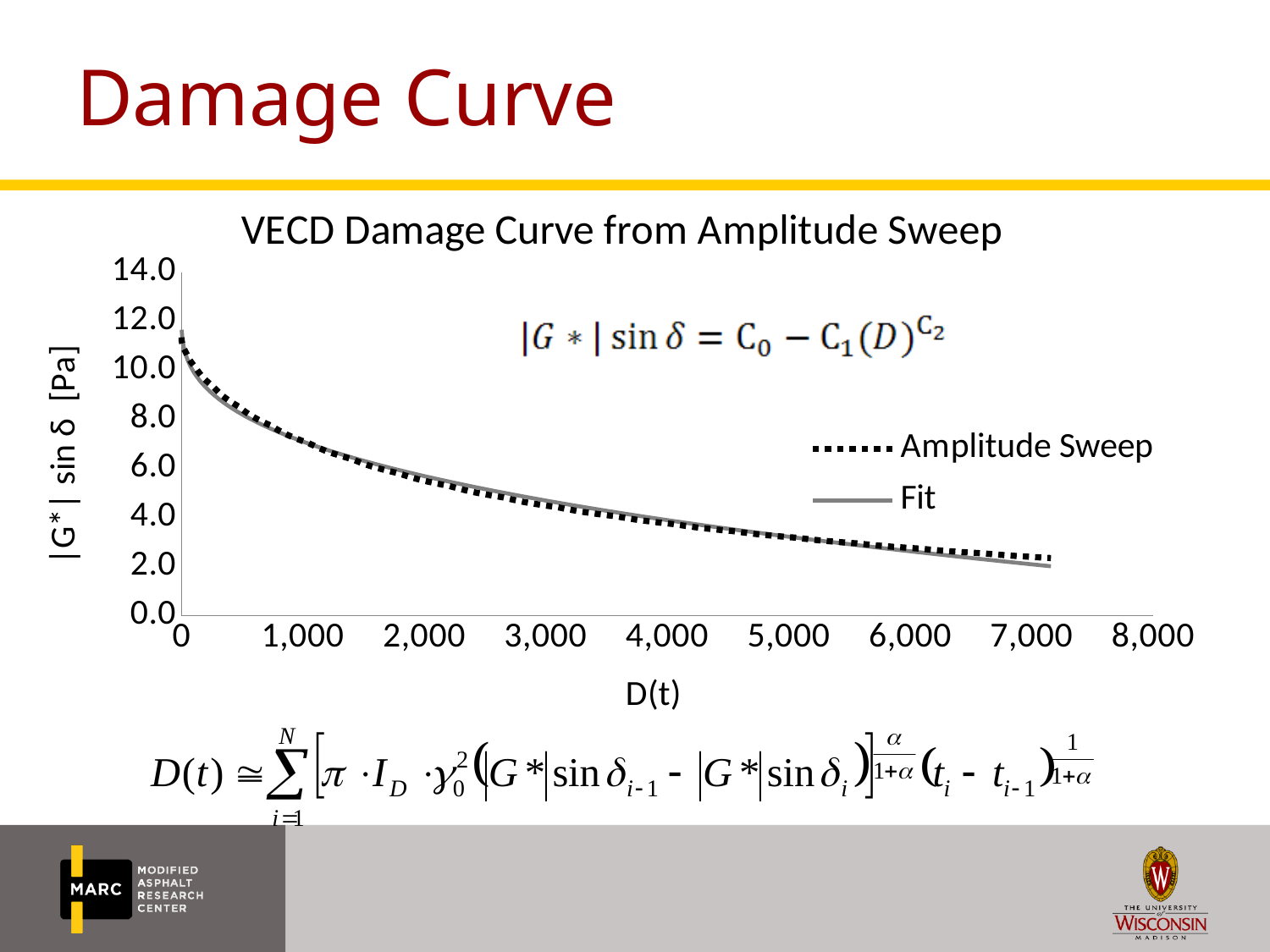
Is the value of the Amplitude Sweep series at D(t) = 1,000 greater or less than 8.0? less Is the value of the Amplitude Sweep series at D(t) = 2,000 greater or less than 4.0? greater How many series does the legend list? 2 What are the two series named in the legend? Amplitude Sweep and Fit Is the value of the Fit series at D(t) = 7,000 greater or less than 4.0? less Do the values of the Fit series rise or fall along the x axis? fall What is the title of the chart? VECD Damage Curve from Amplitude Sweep Do the values of the Amplitude Sweep series rise or fall as D(t) increases? fall What kind of chart is shown on the slide? line chart